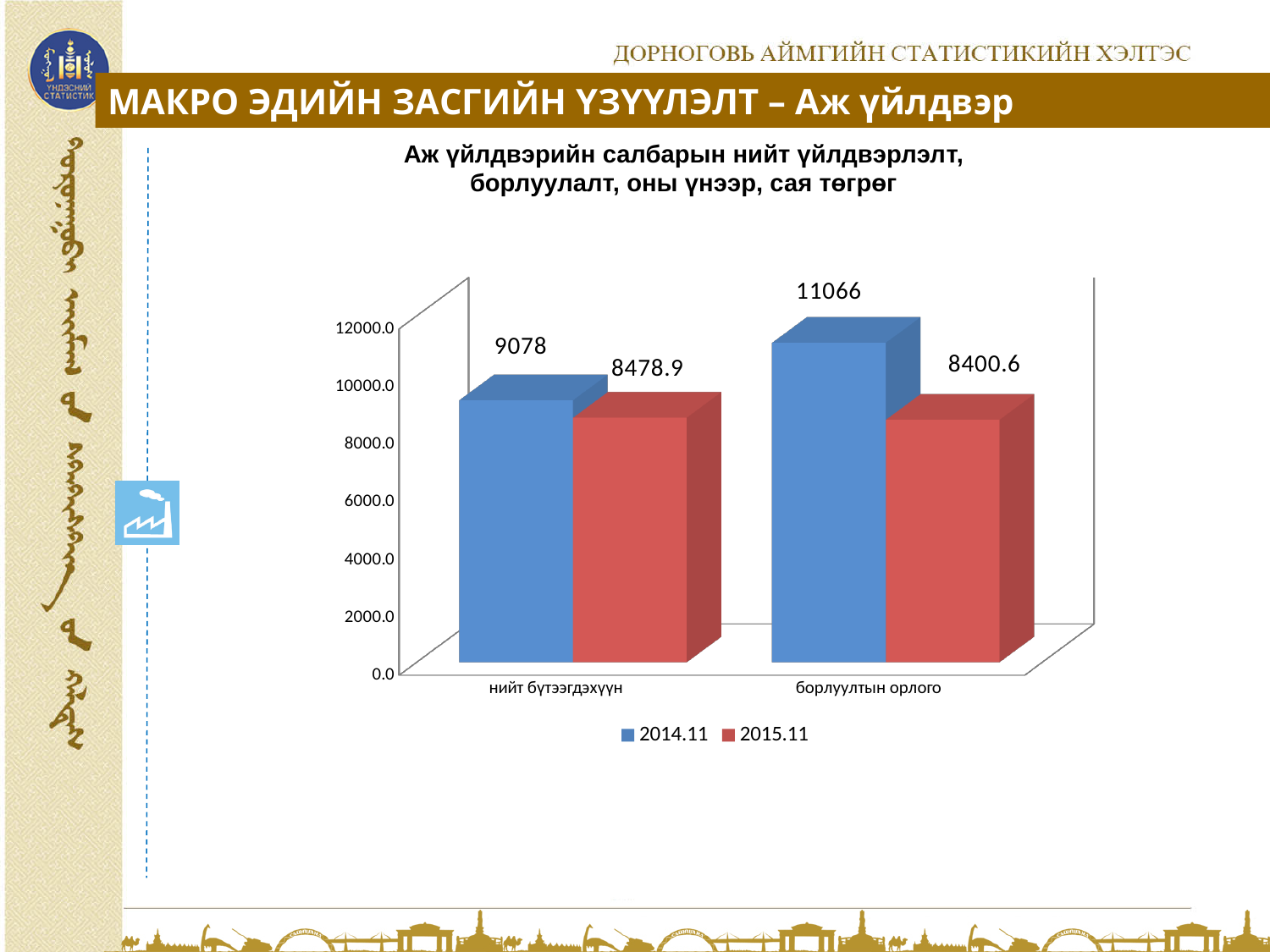
What is the value for нийт бүтээгдэхүүн in the 2014.11 series? 9078 What is the difference between the 2014.11 and 2015.11 values for борлуултын орлого? 2665.4 What is the value for борлуултын орлого in the 2014.11 series? 11066 What is the value for нийт бүтээгдэхүүн in the 2015.11 series? 8478.9 What is the difference between the 2014.11 and 2015.11 values for нийт бүтээгдэхүүн? 599.1 Which is larger: the 2014.11 value for борлуултын орлого or the 2014.11 value for нийт бүтээгдэхүүн? борлуултын орлого (2014.11) Which category has the highest value in the 2014.11 series? борлуултын орлого Which category has the lowest value in the 2015.11 series? борлуултын орлого What is the value for борлуултын орлого in the 2015.11 series? 8400.6 What kind of chart is shown on the slide? Bar chart How many categories are shown on the x axis? 2 How many series does the legend list? 2